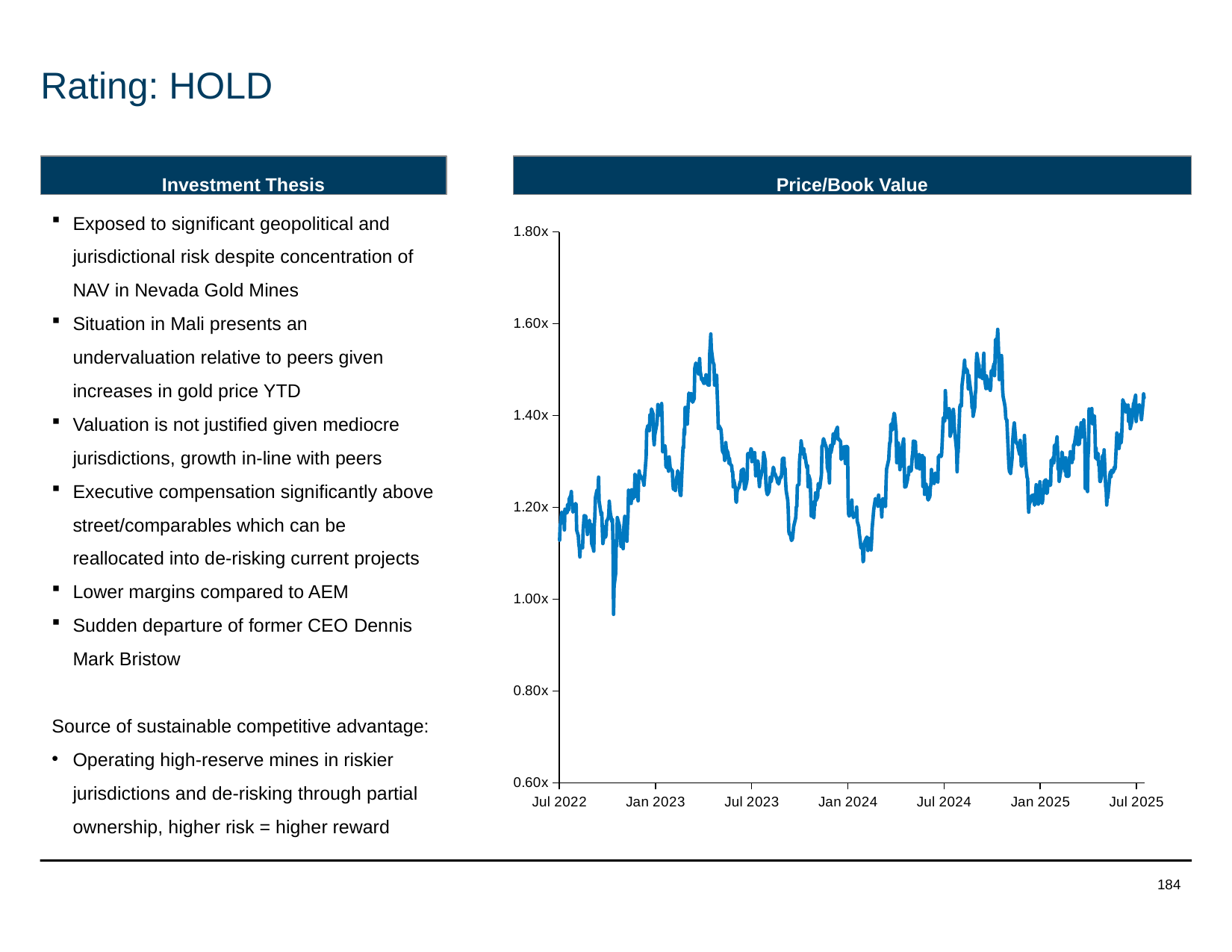
Comparing the start (Jul 2022) to the end (Jul 2025) of the Price/Book Value chart, is the value higher or lower at the end? higher What is the last date label on the x-axis of the Price/Book Value chart? Jul 2025 What is the title of the chart on the right side of the slide? Price/Book Value Is the Price/Book Value at Jul 2024 greater or less than 1.20x? greater How many date labels are shown on the x-axis of the Price/Book Value chart? 7 Is the Price/Book Value at Jul 2023 greater or less than 1.20x? greater Does the Price/Book Value line ever rise above 1.80x? no What is the highest value shown on the y-axis of the Price/Book Value chart? 1.80x What is the first date label on the x-axis of the Price/Book Value chart? Jul 2022 How many lines (series) are plotted on the Price/Book Value chart? 1 What is the lowest value shown on the y-axis of the Price/Book Value chart? 0.60x What kind of chart is shown under the title "Price/Book Value"? line chart